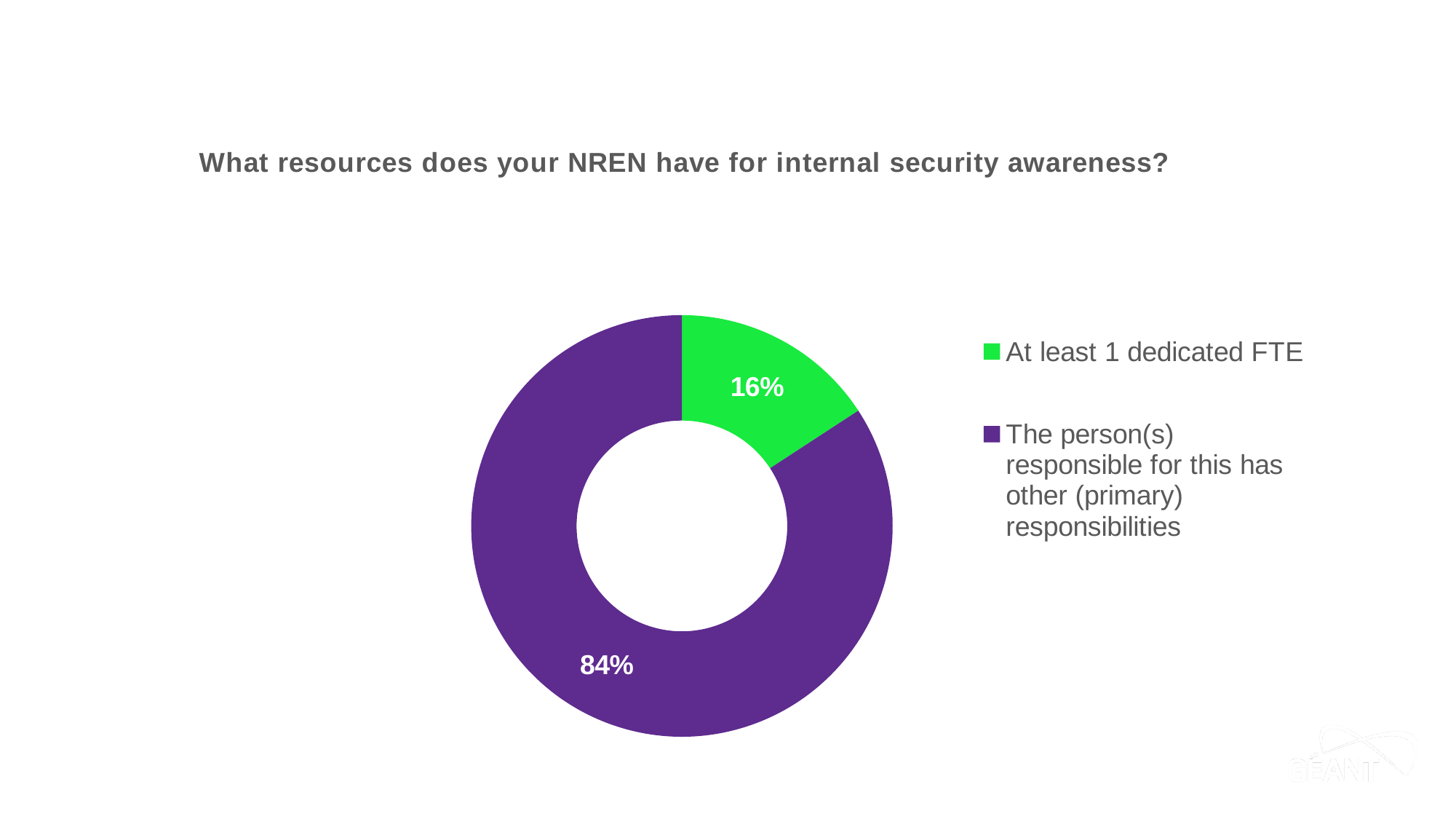
Which category has the largest share of the chart? The person(s) responsible for this has other (primary) responsibilities What colour is the slice for 'At least 1 dedicated FTE'? Green Is the share for 'At least 1 dedicated FTE' greater or less than 50%? less How many categories does the chart show? 2 Which category has the smallest share of the chart? At least 1 dedicated FTE What is the difference in percentage points between the two slices? 68 What is the title of the chart? What resources does your NREN have for internal security awareness? What share of the chart is labelled 'At least 1 dedicated FTE'? 16% Which is larger: the share for 'At least 1 dedicated FTE' or the share for 'The person(s) responsible for this has other (primary) responsibilities'? The person(s) responsible for this has other (primary) responsibilities What kind of chart is shown on the slide? Pie chart (doughnut) What share of the chart is labelled 'The person(s) responsible for this has other (primary) responsibilities'? 84% What do the two slices add up to? 100%